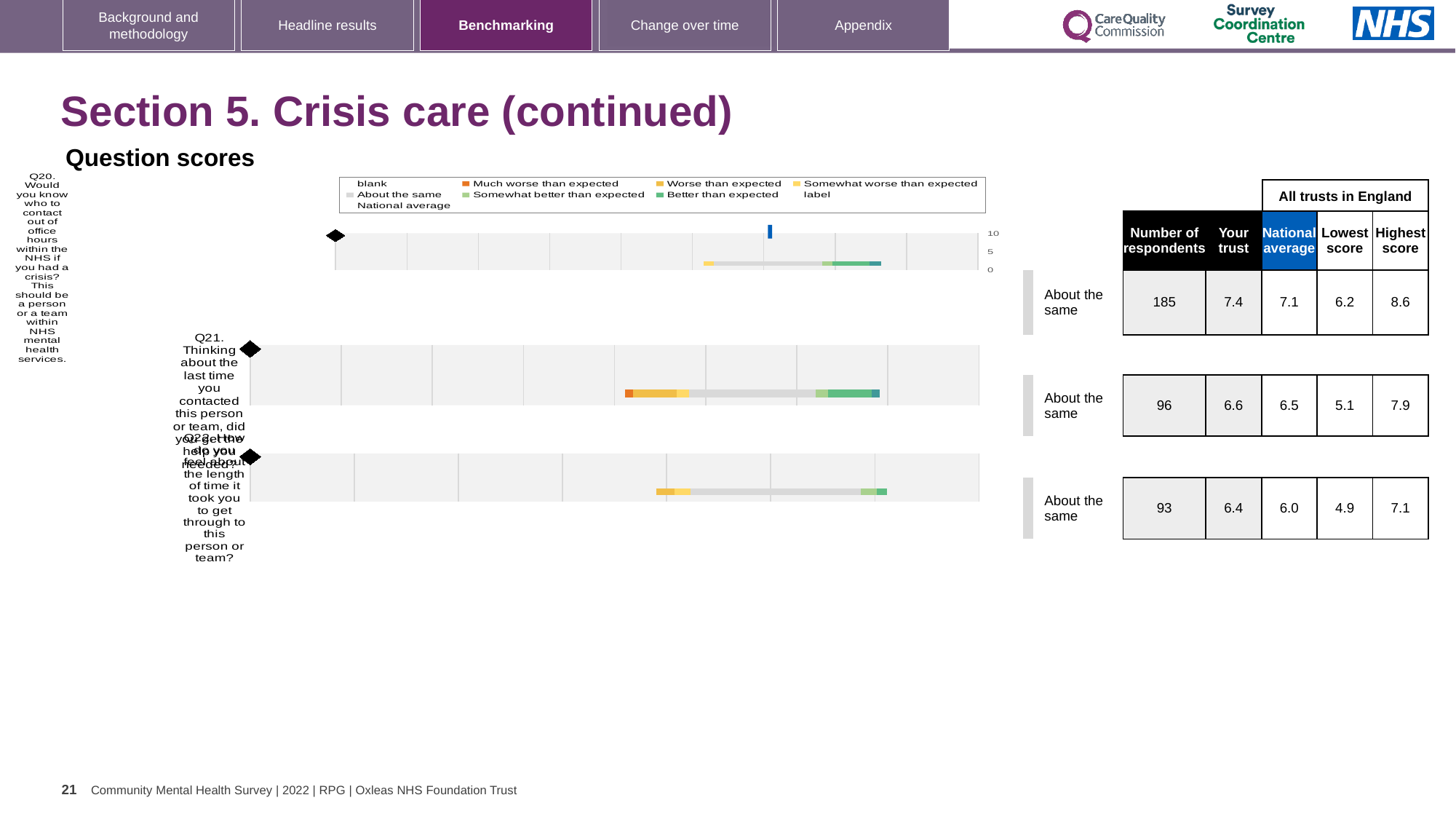
What kind of chart is used to show the question scores on this slide? bar chart Which question has the lowest 'Your trust' score: Q20, Q21 or Q22? Q22 For Q22 (length of time to get through), what is the number of respondents shown? 93 For Q22, which is larger: the 'Your trust' score or the national average? Your trust For Q20 (knowing who to contact out of office hours), what is the 'Your trust' score shown? 7.4 What benchmark category is shown for Q21 (did you get the help you needed)? About the same For Q20, what is the difference between the 'Your trust' score and the national average? 0.3 For Q22, what is the highest score among all trusts in England? 7.1 Which question has the highest 'Your trust' score: Q20, Q21 or Q22? Q20 In the legend, what colour represents 'Much worse than expected'? orange How many questions (Q20, Q21, Q22) are plotted in the question scores charts? 3 For Q21 (did you get the help you needed), what is the national average score shown? 6.5